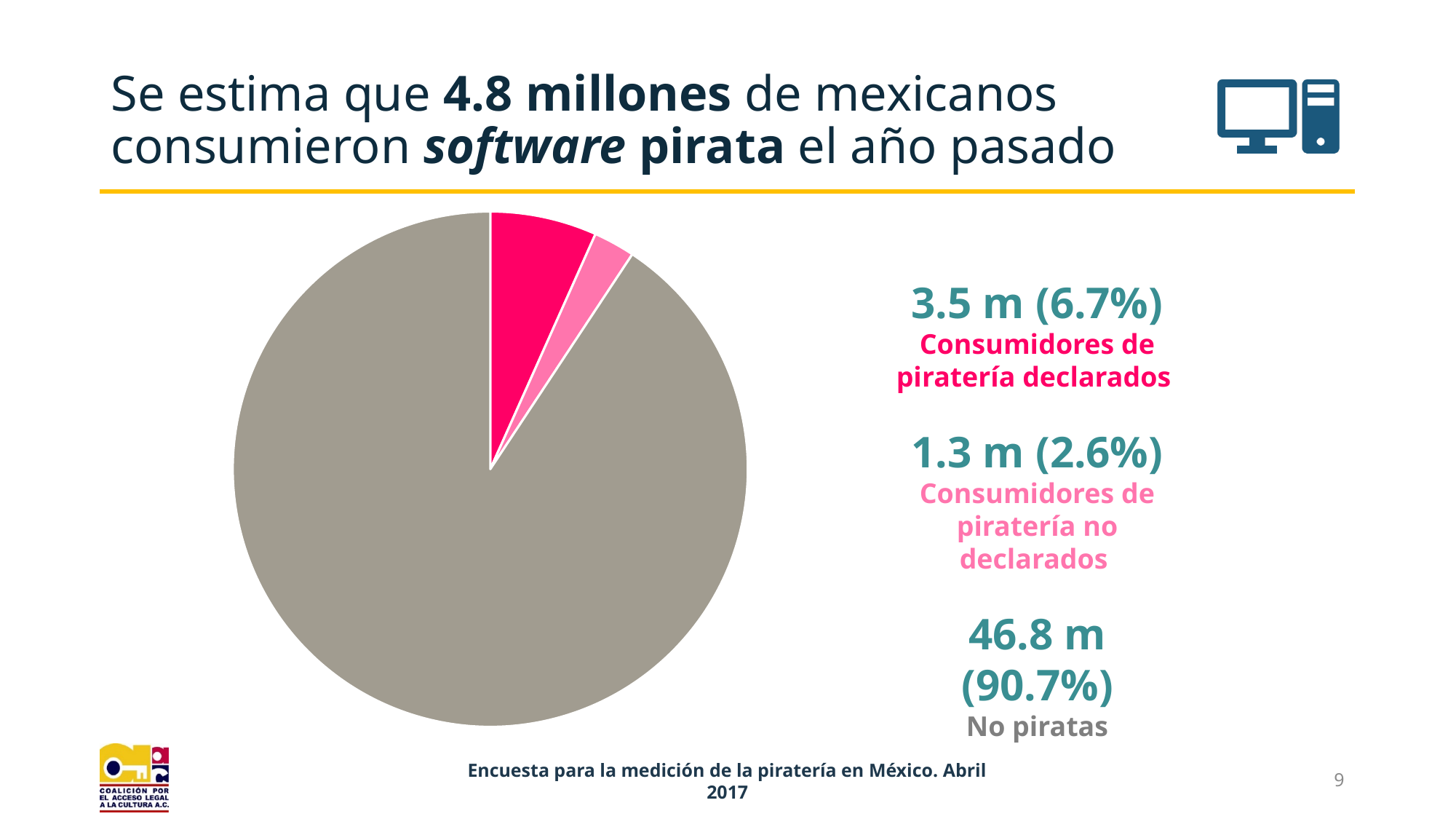
Which category has the smallest slice of the pie? Consumidores de piratería no declarados How many slices does the pie chart have? 3 How many people (in millions) are labelled as 'Consumidores de piratería no declarados'? 1.3 m What share of the pie corresponds to 'Consumidores de piratería no declarados'? 2.6% What is the difference in percentage points between 'Consumidores de piratería declarados' and 'Consumidores de piratería no declarados'? 4.1 percentage points What kind of chart is shown on the slide? Pie chart How many people (in millions) are labelled as 'No piratas'? 46.8 m How many people (in millions) are labelled as 'Consumidores de piratería declarados'? 3.5 m Which category has the largest slice of the pie? No piratas What share of the pie is labelled 'No piratas'? 90.7% What share of the pie corresponds to 'Consumidores de piratería declarados'? 6.7% Which colour is used for the 'No piratas' slice? Grey